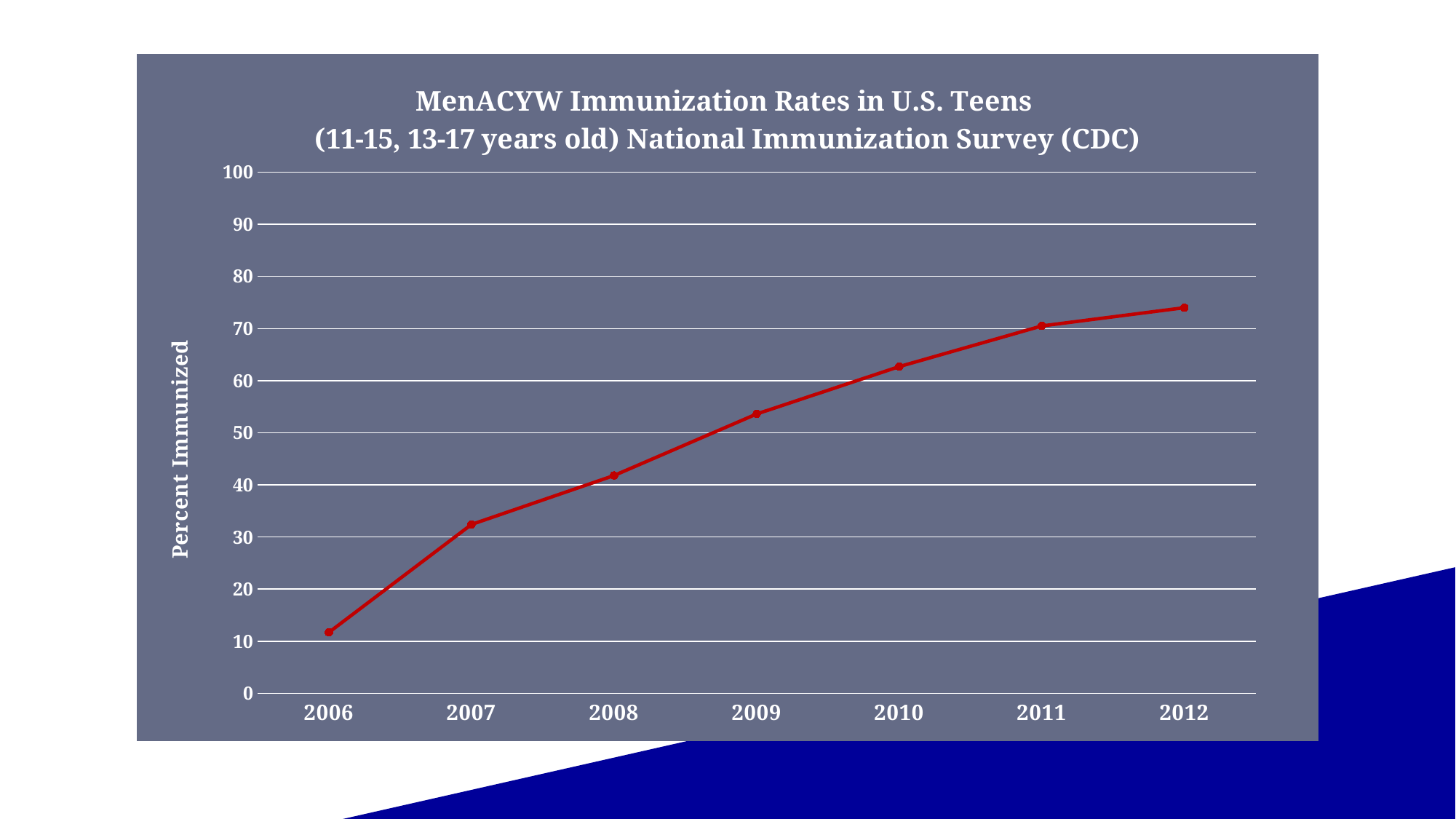
Is the percent immunized in 2009 greater or less than 50? greater How many years are plotted on the x axis? 7 Which year has a higher percent immunized, 2008 or 2011? 2011 Which year has the highest percent immunized? 2012 What kind of chart is shown on the slide? line chart What is the label on the y axis? Percent Immunized Is the percent immunized in 2012 greater or less than 80? less Is the percent immunized in 2010 greater or less than 60? greater Do the immunization rates rise or fall from 2006 to 2012? rise Which year has the lowest percent immunized? 2006 What colour is the plotted line? red